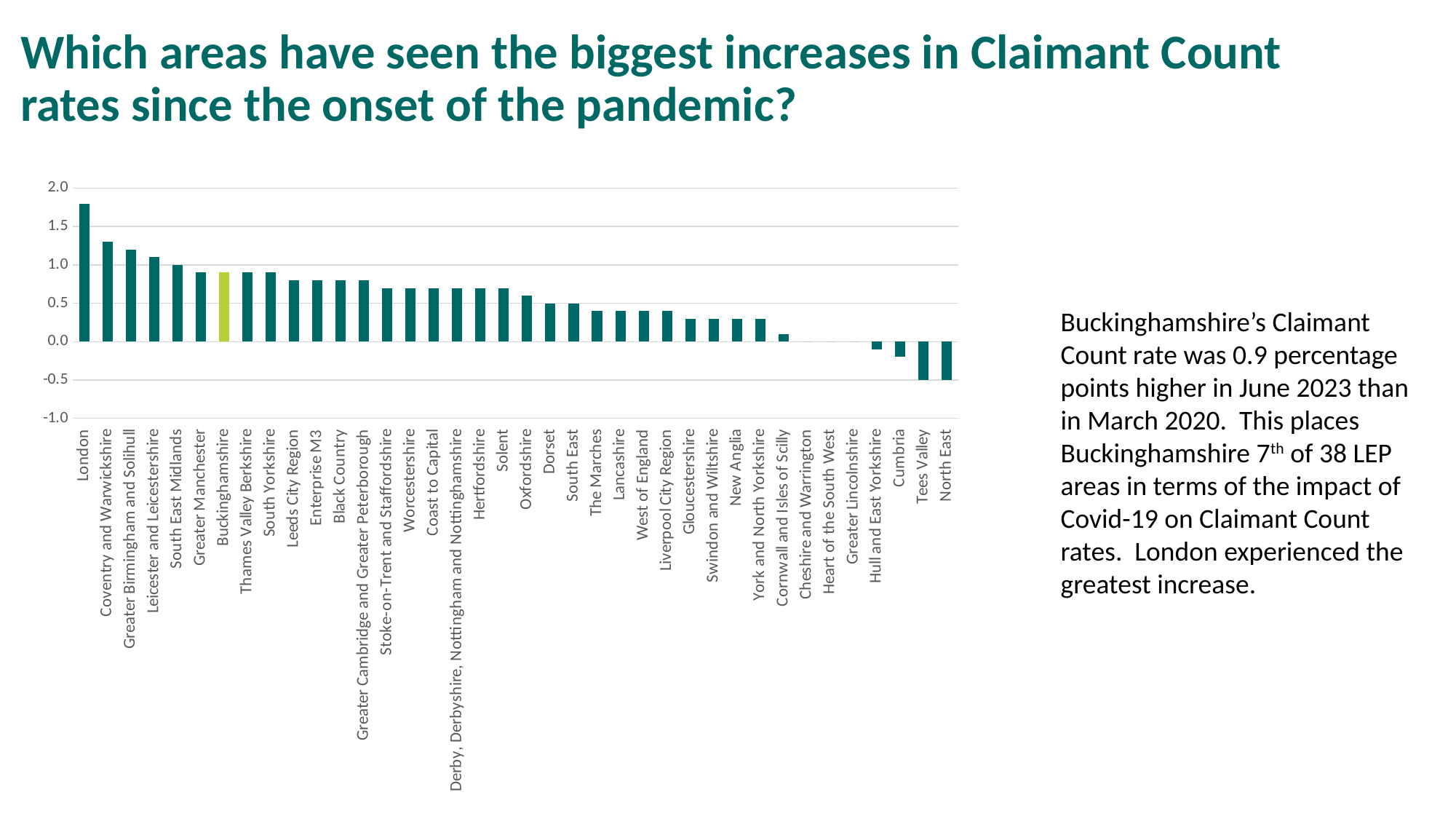
Is the value for Coventry and Warwickshire greater or less than 1.5? less Which area has the highest increase in Claimant Count rate on the chart? London Is the value for Hertfordshire greater or less than 0.5? greater Is the value for Cumbria greater or less than 0.0? less How many LEP areas are plotted on the chart? 38 Which has the larger value, London or Coventry and Warwickshire? London What kind of chart is shown on the slide? bar chart Which has the larger value, Greater Manchester or Oxfordshire? Greater Manchester According to the slide, by how many percentage points was Buckinghamshire's Claimant Count rate higher in June 2023 than in March 2020? 0.9 Do the values rise or fall moving from left to right along the x axis? fall